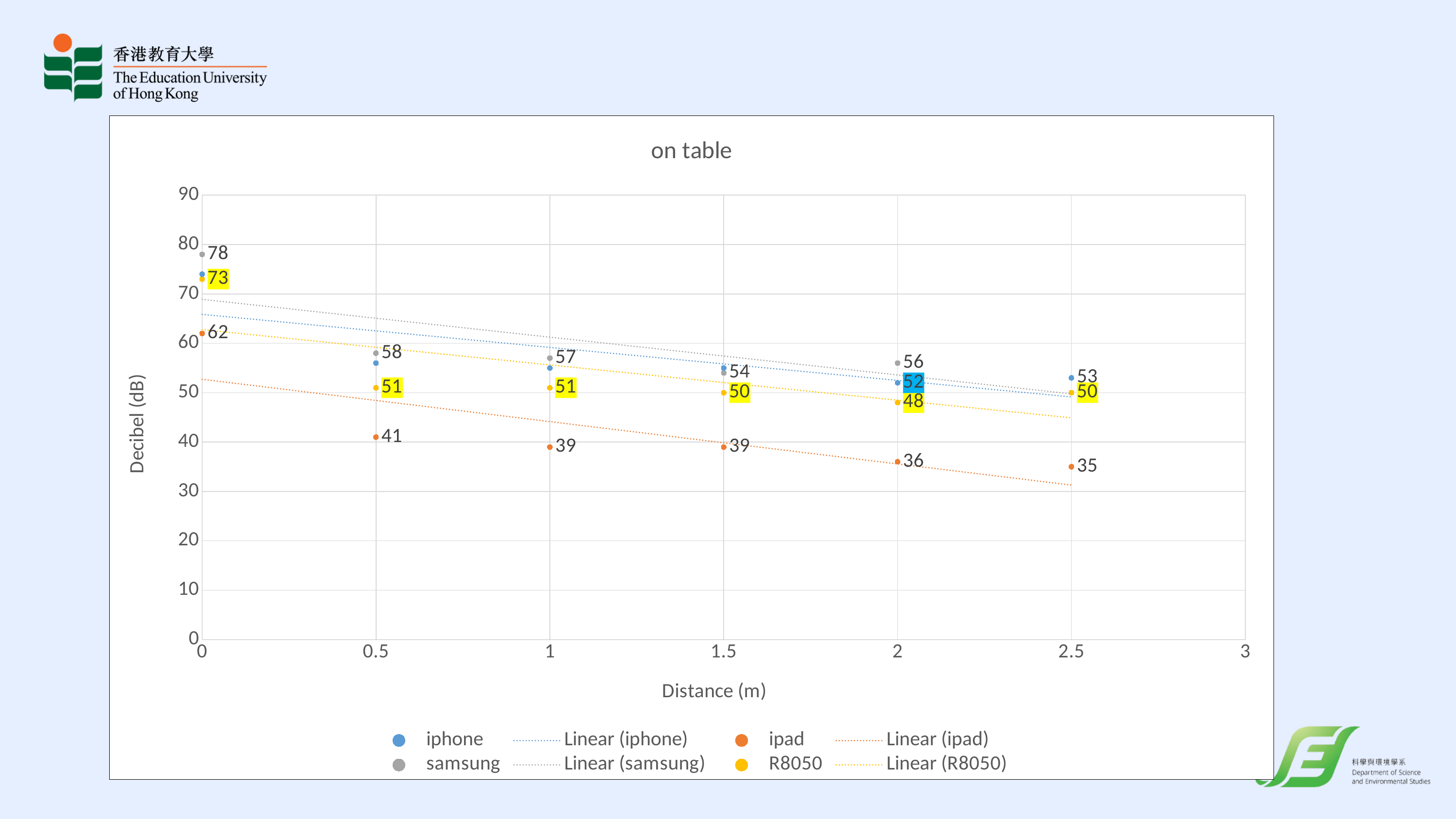
What kind of chart is shown on the slide? scatter chart What is the title of the chart? on table How many entries does the chart legend list? 8 Do the ipad values rise or fall as distance increases? fall What is the decibel value for iphone at a distance of 2 m? 52 Which series has the highest value at a distance of 0 m? samsung What is the decibel value for ipad at a distance of 0 m? 62 What is the lowest decibel value recorded for ipad? 35 What is the decibel value for R8050 at a distance of 2 m? 48 At a distance of 2 m, which is larger: the samsung value or the iphone value? samsung What is the difference between the ipad value at 0 m and the ipad value at 2.5 m? 27 What is the decibel value for samsung at a distance of 0 m? 78